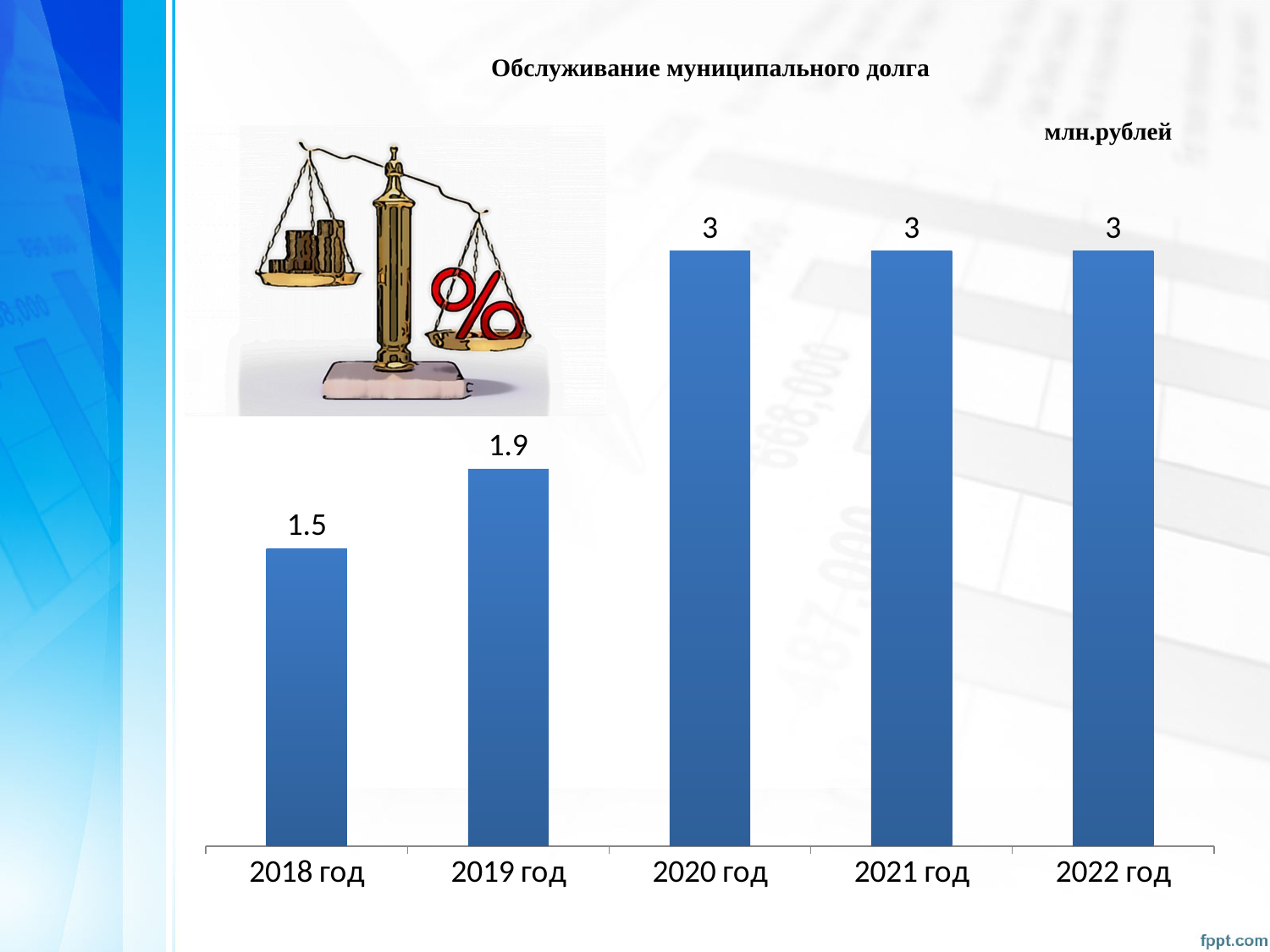
What is the value for 2019 год? 1.9 What kind of chart is shown? bar chart What unit is indicated for the chart values? млн.рублей What is the value for 2021 год? 3 Do the values rise or fall from 2018 год to 2020 год? rise What is the title of the chart? Обслуживание муниципального долга How many years are shown on the x axis? 5 Which is larger, the value for 2019 год or the value for 2022 год? 2022 год What is the value for 2018 год? 1.5 Which year has the lowest value? 2018 год What is the difference between the values for 2020 год and 2019 год? 1.1 What is the difference between the values for 2019 год and 2018 год? 0.4